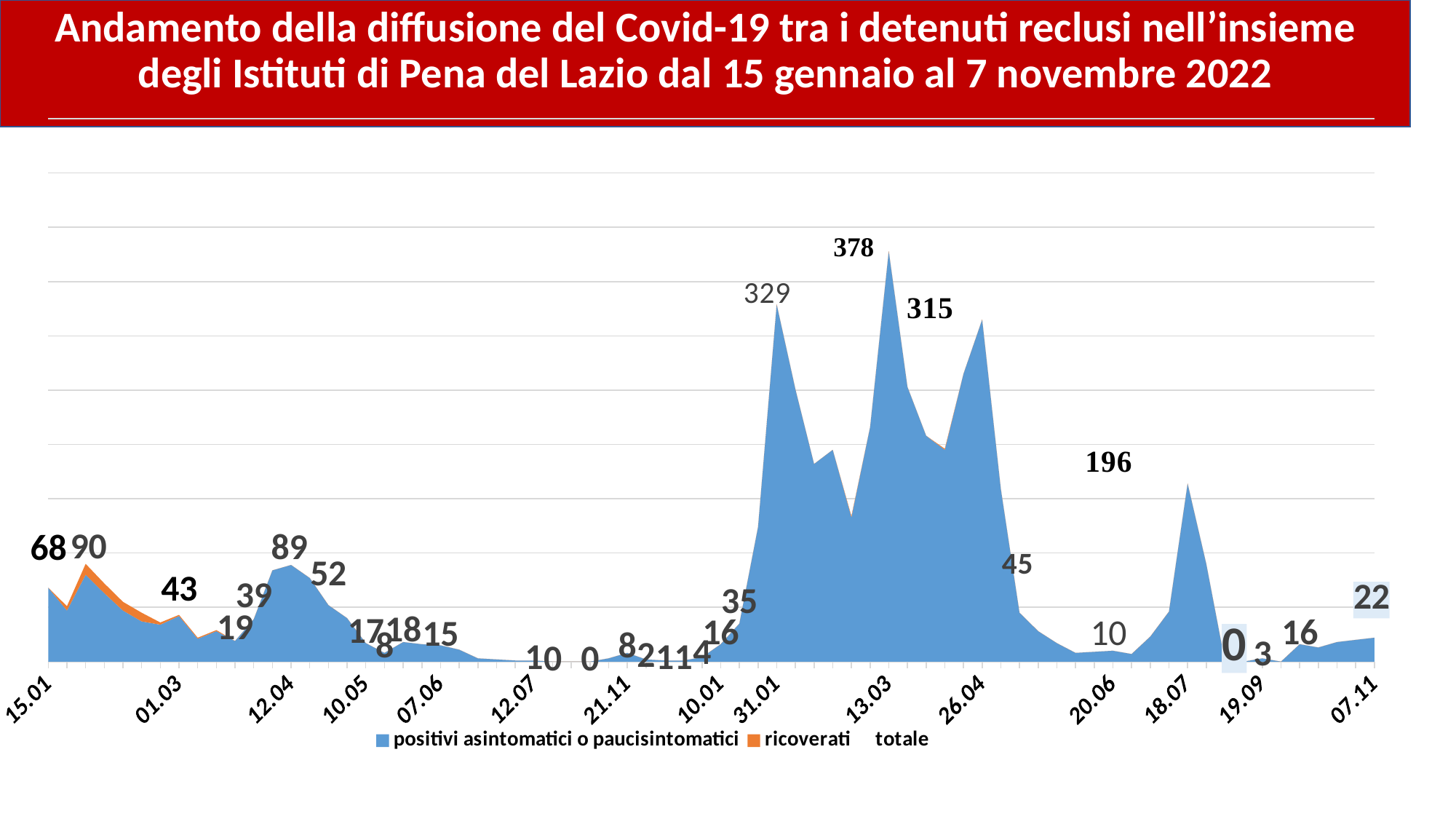
What is the value labelled at the 31.01 date? 329 What type of chart is shown on the slide? area chart What is the value labelled at the first date, 15.01? 68 Which is larger, the value at 31.01 or the value at 18.07? 31.01 Do the values rise or fall from the 13.03 peak to the 26.04 peak? fall Which series in the legend is shown in orange? ricoverati What is the value labelled at the 13.03 date? 378 What is the highest value labelled on the chart? 378 How many series does the legend list? 3 What is the difference between the peak value 378 and the earlier peak of 329? 49 What is the value labelled at the last date, 07.11? 22